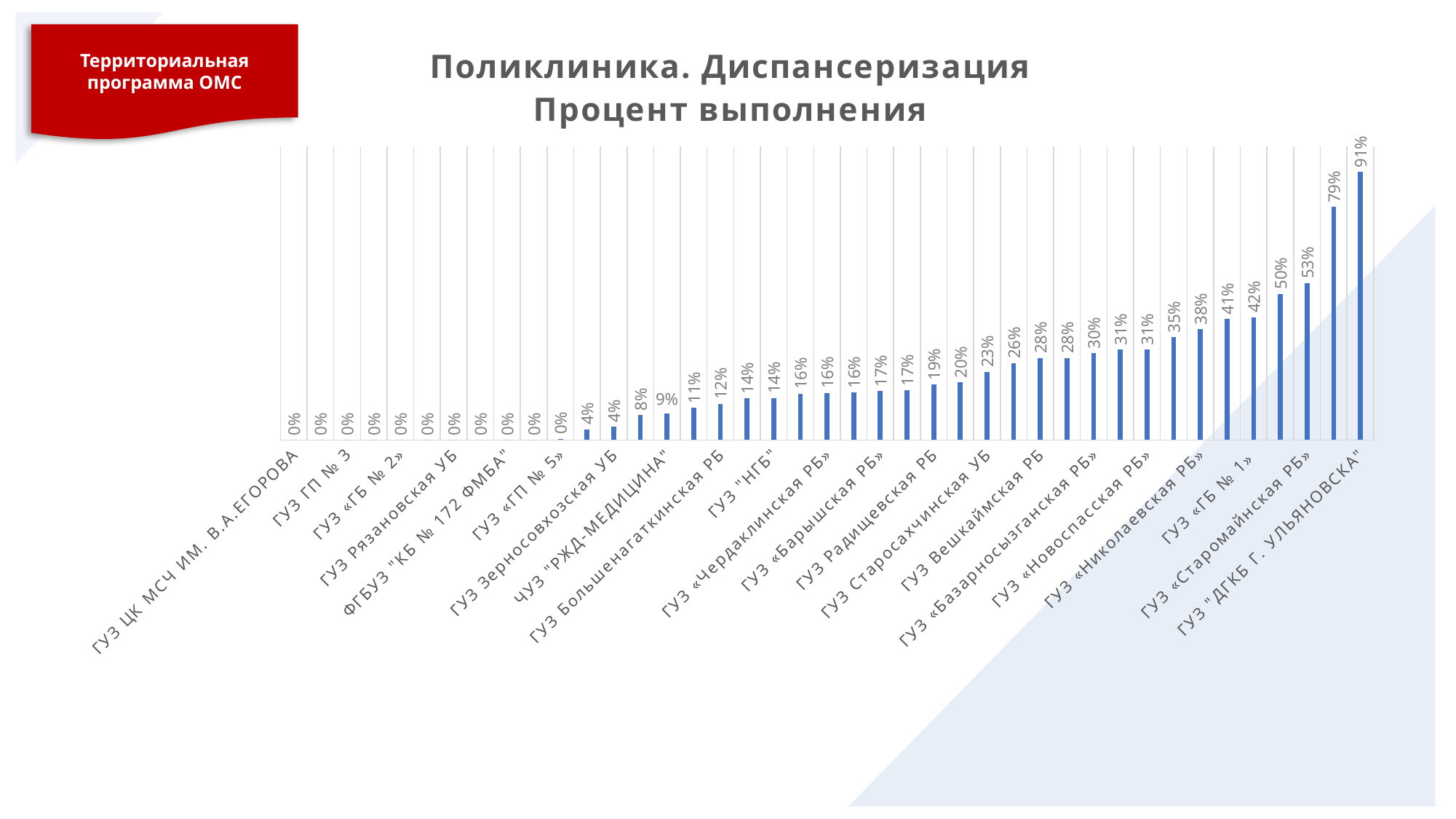
What is the value for ГУЗ "ДГКБ Г. УЛЬЯНОВСКА"? 91% What is the value for ГУЗ ЦК МСЧ ИМ. В.А.ЕГОРОВА? 0% Do the values rise or fall from left to right along the x axis? rise What is the difference between the values for ГУЗ "ДГКБ Г. УЛЬЯНОВСКА" and ГУЗ «Старомайнская РБ»? 38% What is the value for ГУЗ Вешкаймская РБ? 28% What type of chart is shown on the slide? bar chart Which is larger, the value for ГУЗ «Николаевская РБ» or for ГУЗ Вешкаймская РБ? ГУЗ «Николаевская РБ» Which institution has the highest value on the chart? ГУЗ "ДГКБ Г. УЛЬЯНОВСКА" What is the value for ГУЗ «ГБ № 1»? 42% What is the value for ГУЗ «Старомайнская РБ»? 53% What is the value for ГУЗ «Николаевская РБ»? 38% What is the title of the chart? Поликлиника. Диспансеризация Процент выполнения